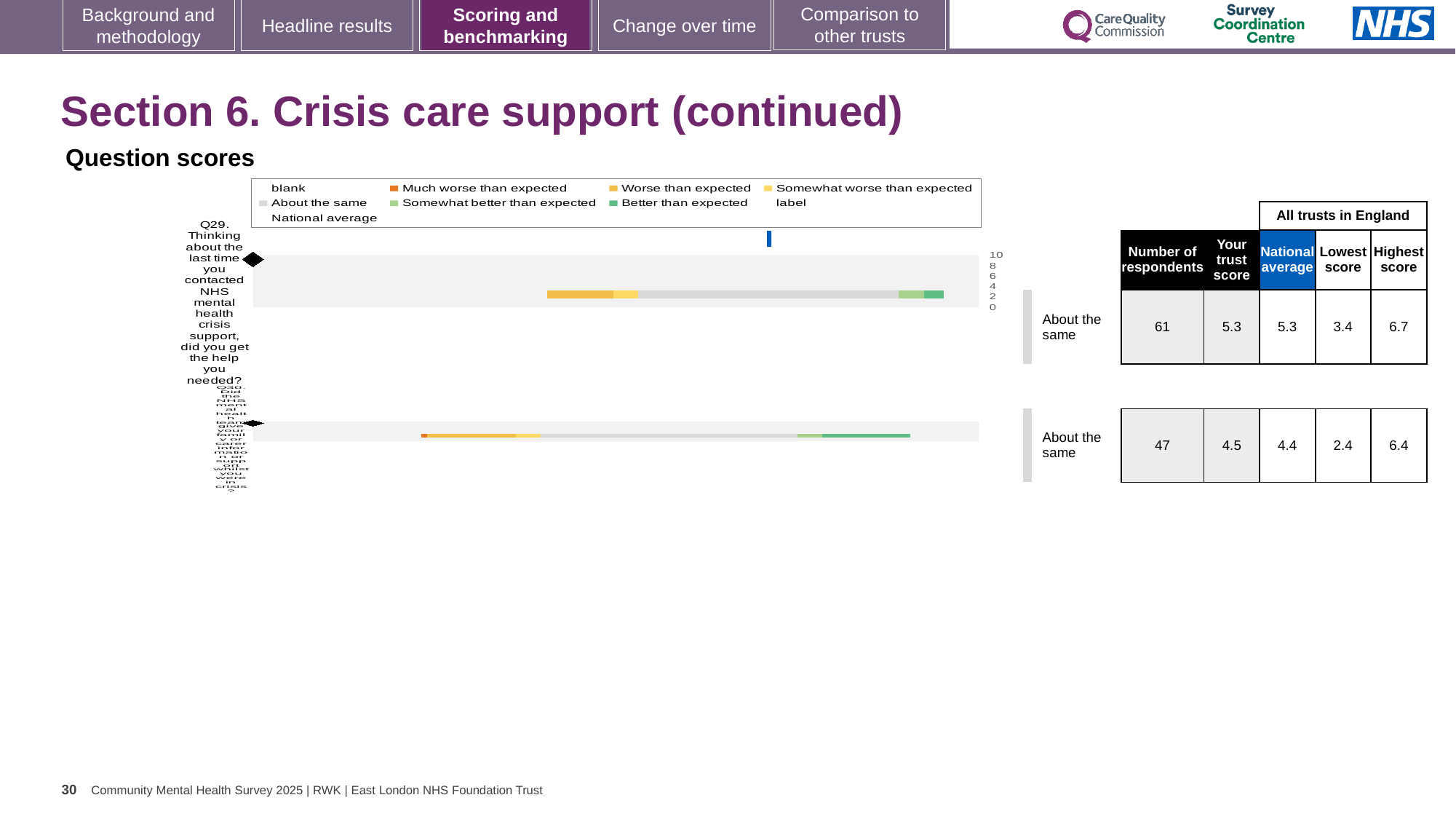
How many entries does the chart legend list? 9 What benchmark category is shown for Q29 next to the chart? About the same What is the highest score across all trusts in England for Q29? 6.7 What kind of chart is shown under 'Question scores'? bar chart What is the trust score for Q30 in the table next to the chart? 4.5 What is the lowest score across all trusts in England for Q30? 2.4 What is the highest tick value shown on the chart's axis? 10 What is the number of respondents for Q29 in the table next to the chart? 61 What is the national average for Q29 in the table next to the chart? 5.3 What is the difference between the highest score and the lowest score for Q30? 4.0 How many questions (categories) are plotted in the chart? 2 Which question has more respondents, Q29 or Q30? Q29